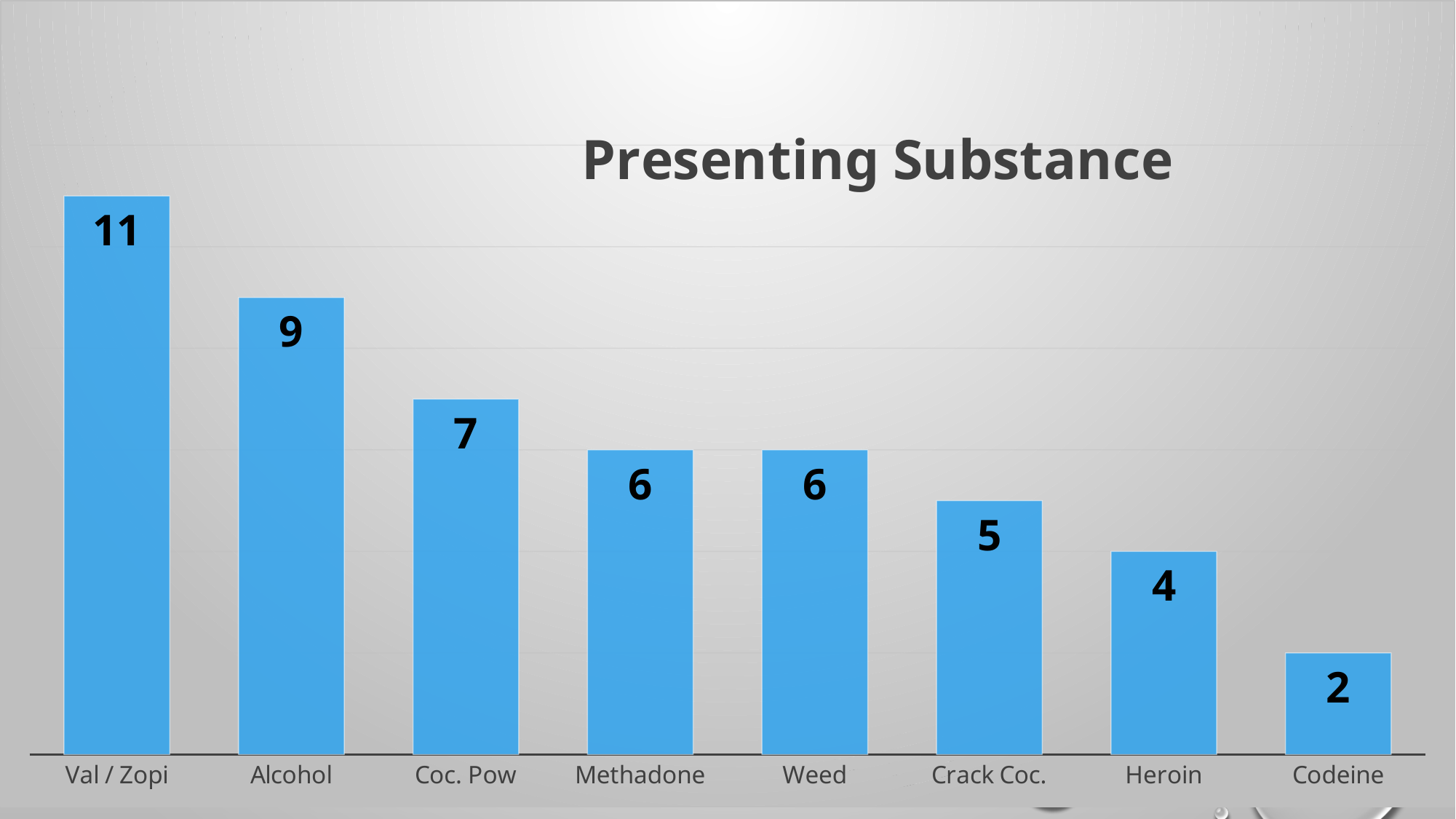
What is the difference between the values for Coc. Pow and Heroin? 3 What is the title of the chart? Presenting Substance What is the value for Alcohol? 9 Which category has the lowest value? Codeine Which category has the highest value? Val / Zopi Which is larger, the value for Methadone or the value for Crack Coc.? Methadone What kind of chart is shown? Bar chart What is the difference between the values for Val / Zopi and Alcohol? 2 What is the value for Crack Coc.? 5 Do the values rise or fall from left to right along the x axis? Fall How many categories are shown on the x axis? 8 What is the value for Codeine? 2